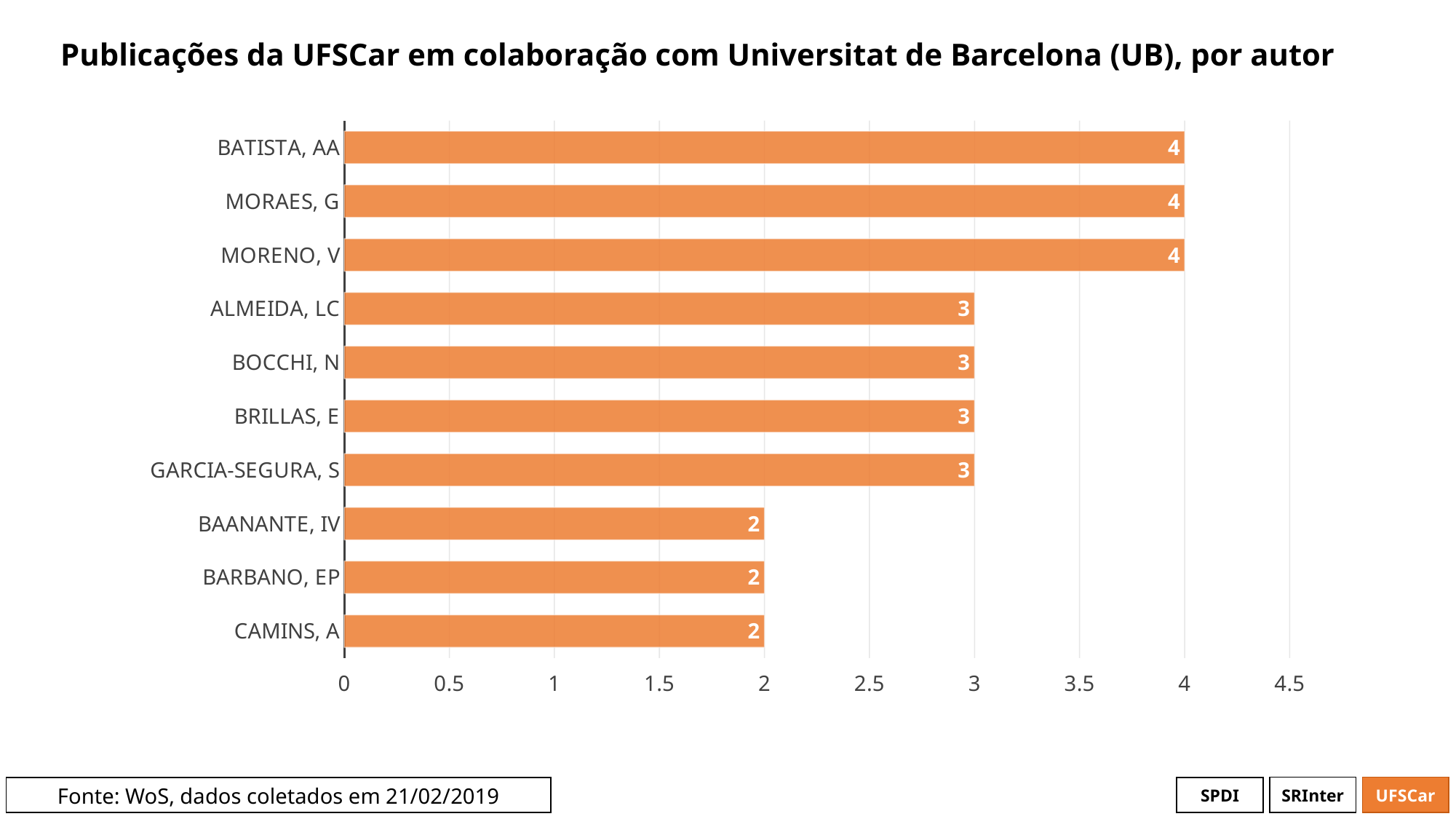
How many authors are shown in the chart? 10 Which has a larger value, BOCCHI, N or BAANANTE, IV? BOCCHI, N What kind of chart is shown on the slide? bar chart What is the lowest value shown in the chart? 2 What is the value for GARCIA-SEGURA, S? 3 What is the source stated at the bottom of the slide? WoS, dados coletados em 21/02/2019 What is the title of the chart? Publicações da UFSCar em colaboração com Universitat de Barcelona (UB), por autor What is the value for ALMEIDA, LC? 3 Is the value for BRILLAS, E greater or less than 2.5? greater What is the value for BATISTA, AA? 4 What is the value for CAMINS, A? 2 What is the difference between the values for MORENO, V and BARBANO, EP? 2